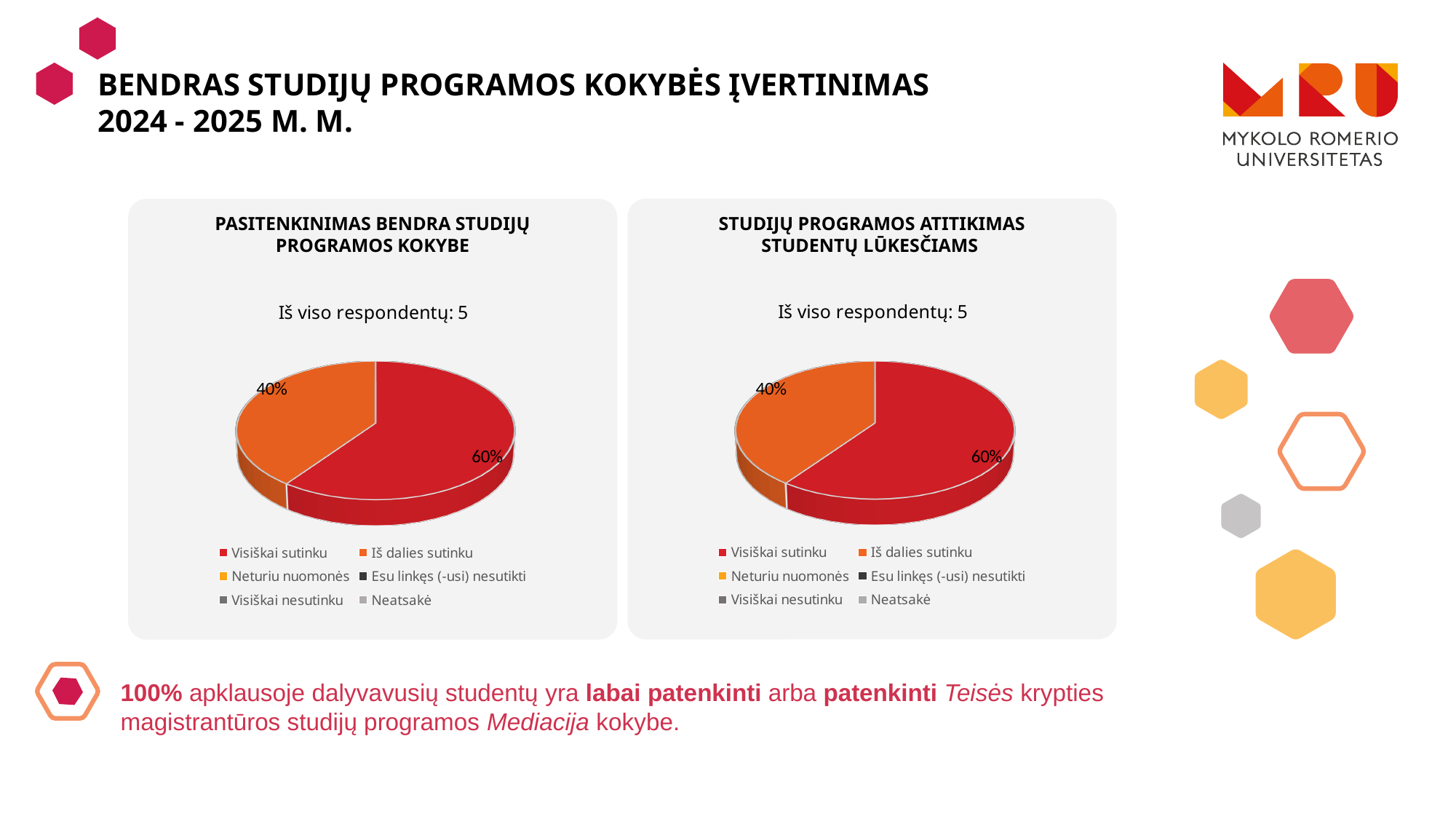
In the right chart, which response category has the smallest visible slice? Iš dalies sutinku In the right chart, which slice is larger: "Visiškai sutinku" or "Iš dalies sutinku"? Visiškai sutinku In the chart titled "Pasitenkinimas bendra studijų programos kokybe", what share of respondents answered "Visiškai sutinku"? 60% In the chart titled "Studijų programos atitikimas studentų lūkesčiams", what share of respondents answered "Iš dalies sutinku"? 40% How many slices with data labels are shown in the right chart? 2 In the left chart, which response category has the largest slice? Visiškai sutinku What type of chart is used in the "Pasitenkinimas bendra studijų programos kokybe" panel? Pie chart In the chart titled "Pasitenkinimas bendra studijų programos kokybe", what share of respondents answered "Iš dalies sutinku"? 40% According to the left chart panel, how many respondents in total took part ("Iš viso respondentų")? 5 How many entries does the legend of the left chart list? 6 In the left chart, what is the difference in percentage points between the "Visiškai sutinku" and "Iš dalies sutinku" slices? 20 percentage points In the chart titled "Studijų programos atitikimas studentų lūkesčiams", what share of respondents answered "Visiškai sutinku"? 60%